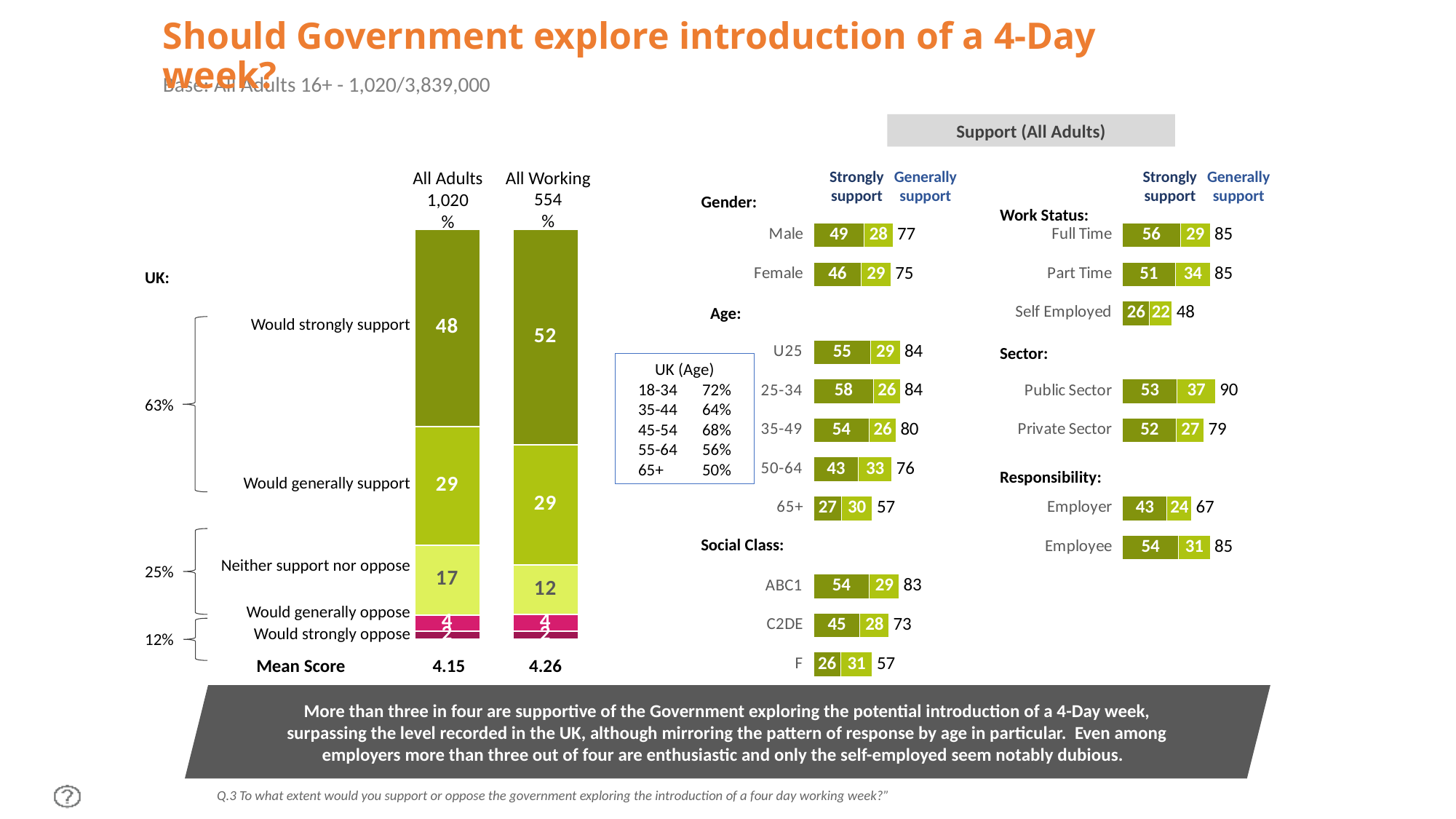
In the Support (All Adults) chart on the right, which subgroup has the lowest total support? Self Employed In the stacked bar chart on the left, what percentage of All Working would strongly support a 4-Day week? 52 In the stacked bar chart on the left, what is the difference between the 'Neither support nor oppose' values for All Adults and All Working? 5 In the Support (All Adults) chart on the right, what is the 'Strongly support' value for the Public Sector? 53 In the stacked bar chart on the left, what kind of chart is used to show the All Adults and All Working responses? Stacked bar chart In the stacked bar chart on the left, what percentage of All Adults would strongly support a 4-Day week? 48 In the Support (All Adults) chart on the right, what is the difference in total support between Full Time and Self Employed? 37 In the Support (All Adults) chart on the right, which age group has a higher 'Strongly support' value, 25-34 or 50-64? 25-34 In the Support (All Adults) chart on the right, which subgroup has the highest total support? Public Sector In the Support (All Adults) chart on the right, what is the total support for Employers? 67 In the stacked bar chart on the left, what is the Mean Score for All Working? 4.26 In the Support (All Adults) chart on the right, how many age groups are shown? 5